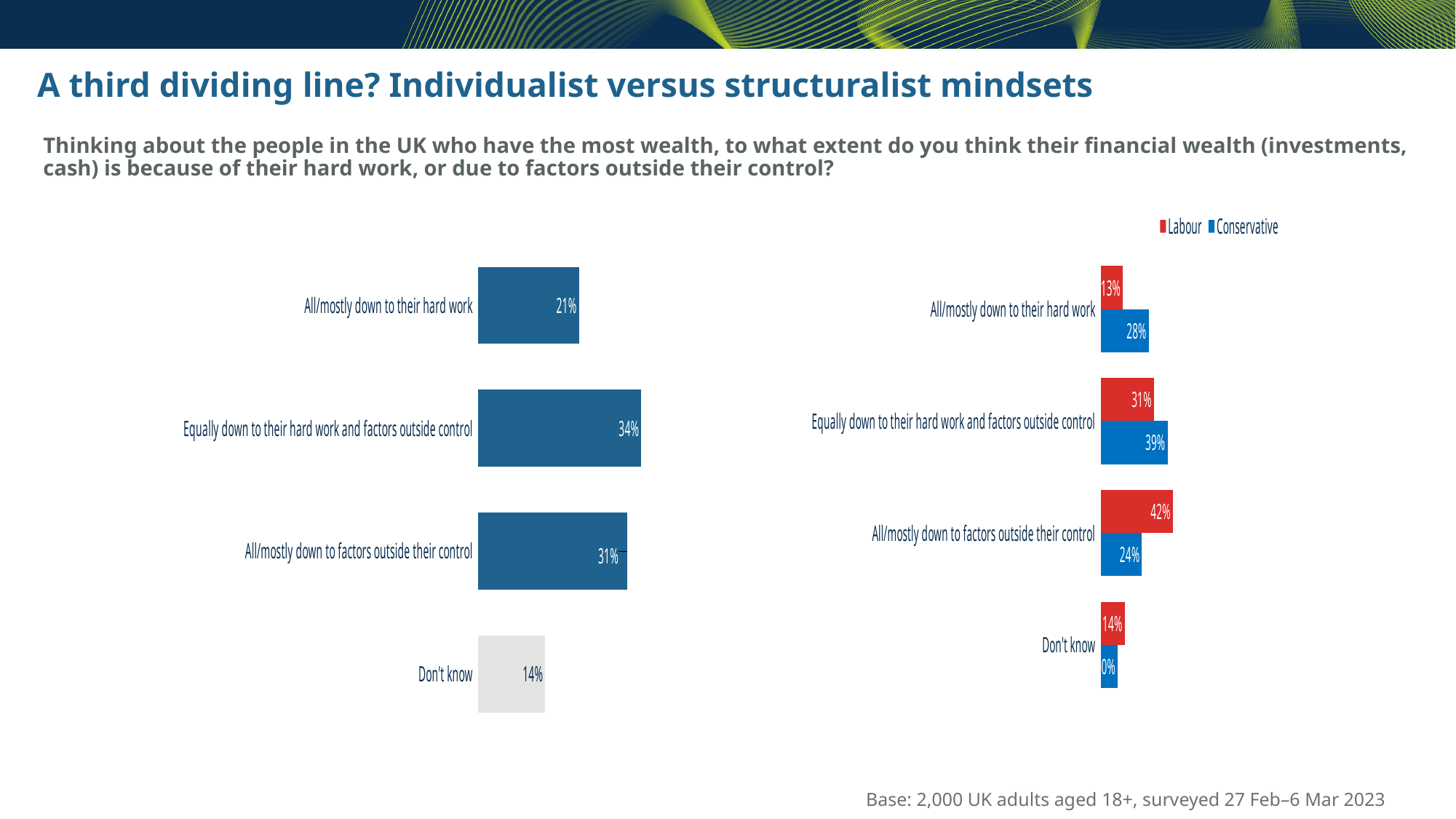
In the left-hand chart, which response has the highest percentage? Equally down to their hard work and factors outside control In the left-hand chart, which response has the lowest percentage? Don't know In the left-hand chart, what is the difference between 'Equally down to their hard work and factors outside control' and 'All/mostly down to factors outside their control'? 3 percentage points How many response categories are shown in the left-hand chart? 4 In the right-hand chart, what percentage of Labour voters say wealth is all/mostly down to factors outside their control? 42% In the right-hand chart, what is the difference between Labour and Conservative for 'All/mostly down to factors outside their control'? 18 percentage points What type of chart is the right-hand chart? Bar chart In the right-hand chart, which is larger for 'Equally down to their hard work and factors outside control': Labour or Conservative? Conservative In the left-hand chart, what percentage say the wealth of the richest is all/mostly down to their hard work? 21% In the left-hand chart, what percentage answered 'Don't know'? 14% How many series does the legend of the right-hand chart list? 2 In the right-hand chart, what percentage of Conservative voters say wealth is all/mostly down to their hard work? 28%